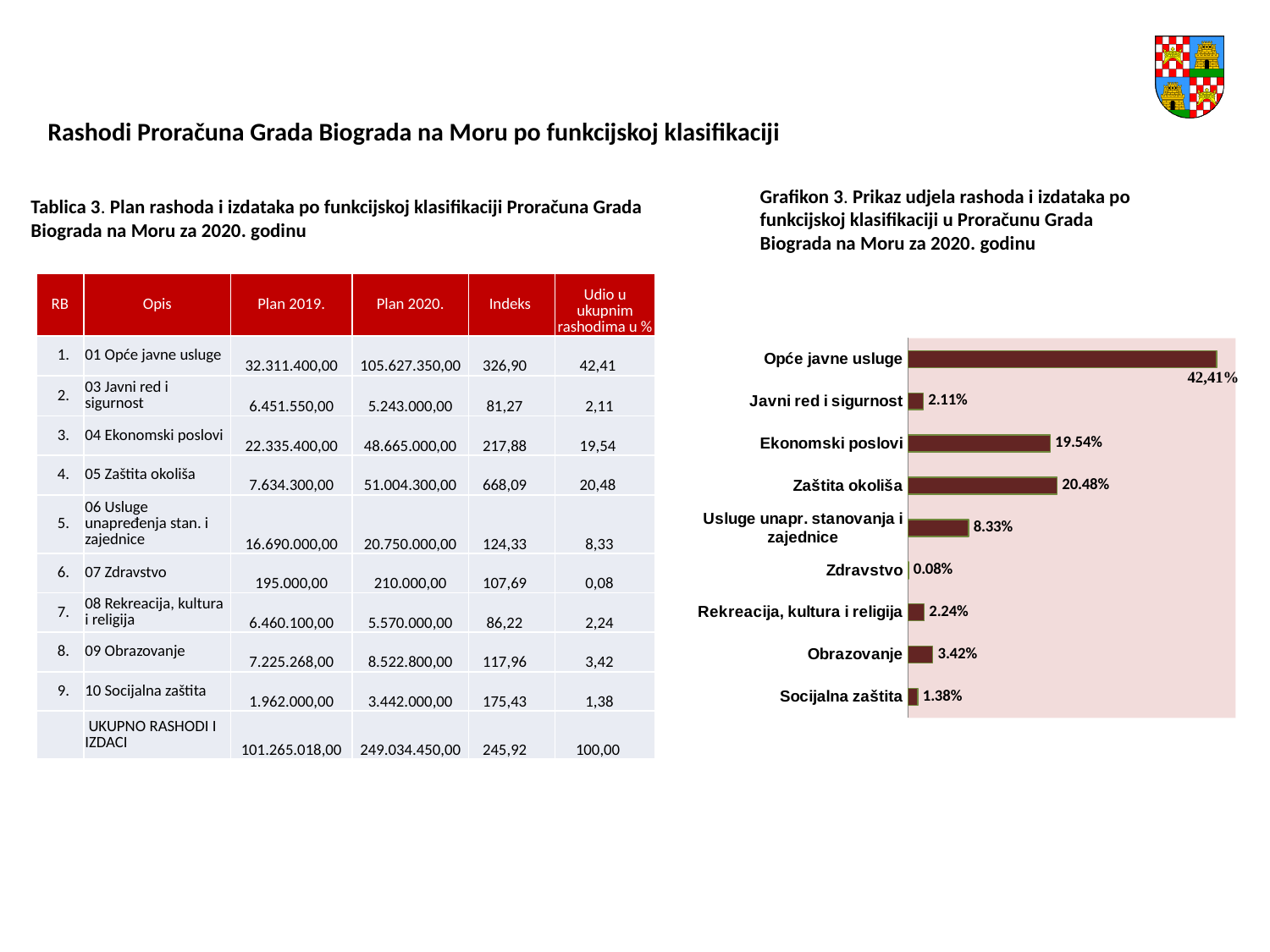
What is the value shown for Zaštita okoliša? 20.48% What is the difference between the values for Zaštita okoliša and Ekonomski poslovi? 0.94% Which category has the lowest value in the chart? Zdravstvo What is the value shown for Usluge unapr. stanovanja i zajednice? 8.33% What is the title of the chart? Grafikon 3. Prikaz udjela rashoda i izdataka po funkcijskoj klasifikaciji u Proračunu Grada Biograda na Moru za 2020. godinu What is the value shown for Zdravstvo? 0.08% What kind of chart is shown on the slide? Bar chart What is the difference between the values for Obrazovanje and Socijalna zaštita? 2.04% What is the value shown for Opće javne usluge? 42,41% Which category has the highest value in the chart? Opće javne usluge How many categories are shown in the chart? 9 Which is larger, the value for Obrazovanje or the value for Rekreacija, kultura i religija? Obrazovanje